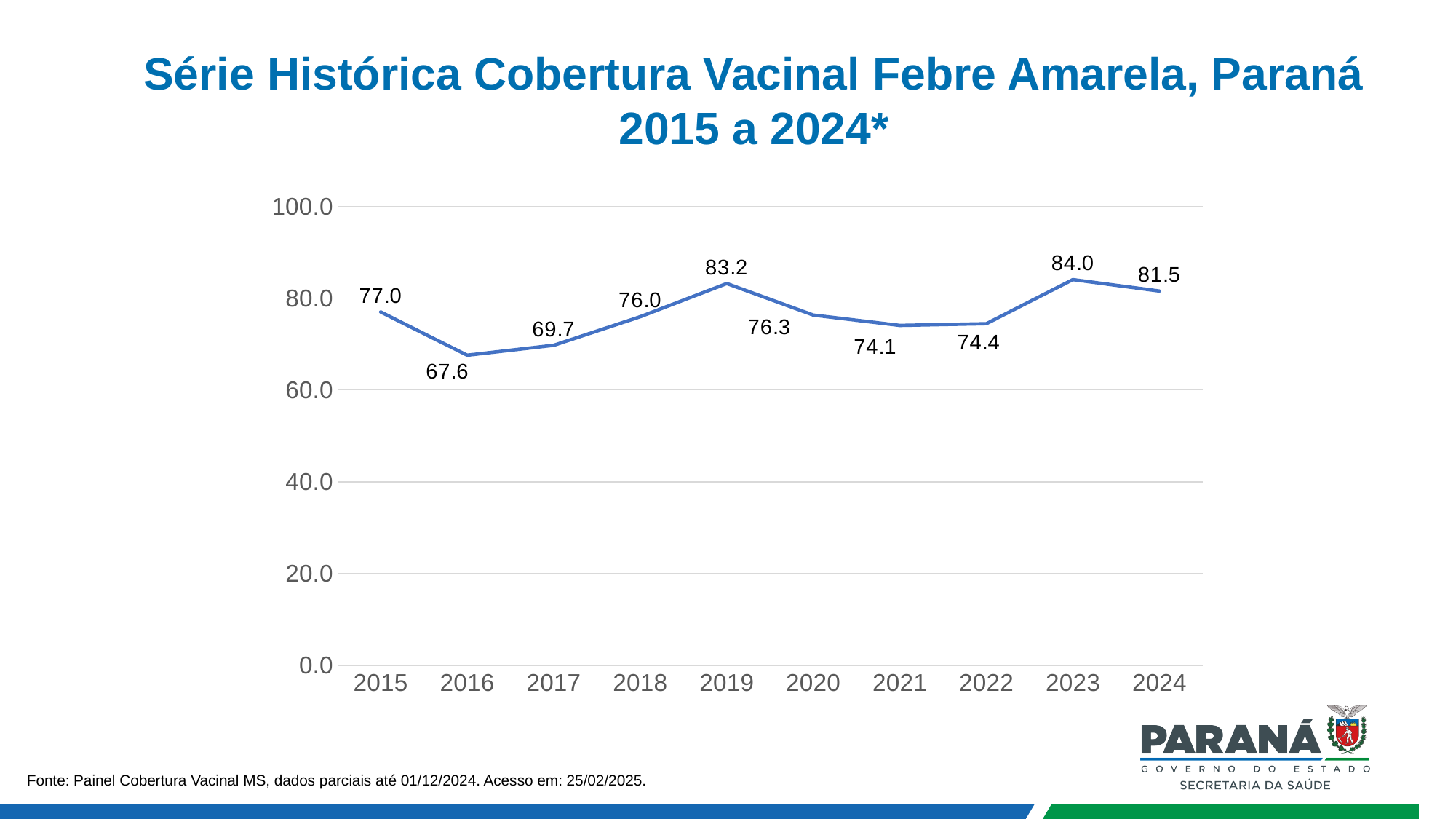
Does the value rise or fall from 2016 to 2019? rise What is the difference between the values for 2023 and 2016? 16.4 Is the value for 2021 greater or less than 80.0? less What is the vaccination coverage value for 2016? 67.6 What kind of chart is shown on the slide? line chart Which year has the lowest vaccination coverage? 2016 Which year has the highest vaccination coverage? 2023 What is the vaccination coverage value for 2019? 83.2 Which year has a higher value, 2015 or 2018? 2015 What is the difference between the values for 2019 and 2020? 6.9 How many years are plotted on the chart? 10 What is the vaccination coverage value for 2024? 81.5